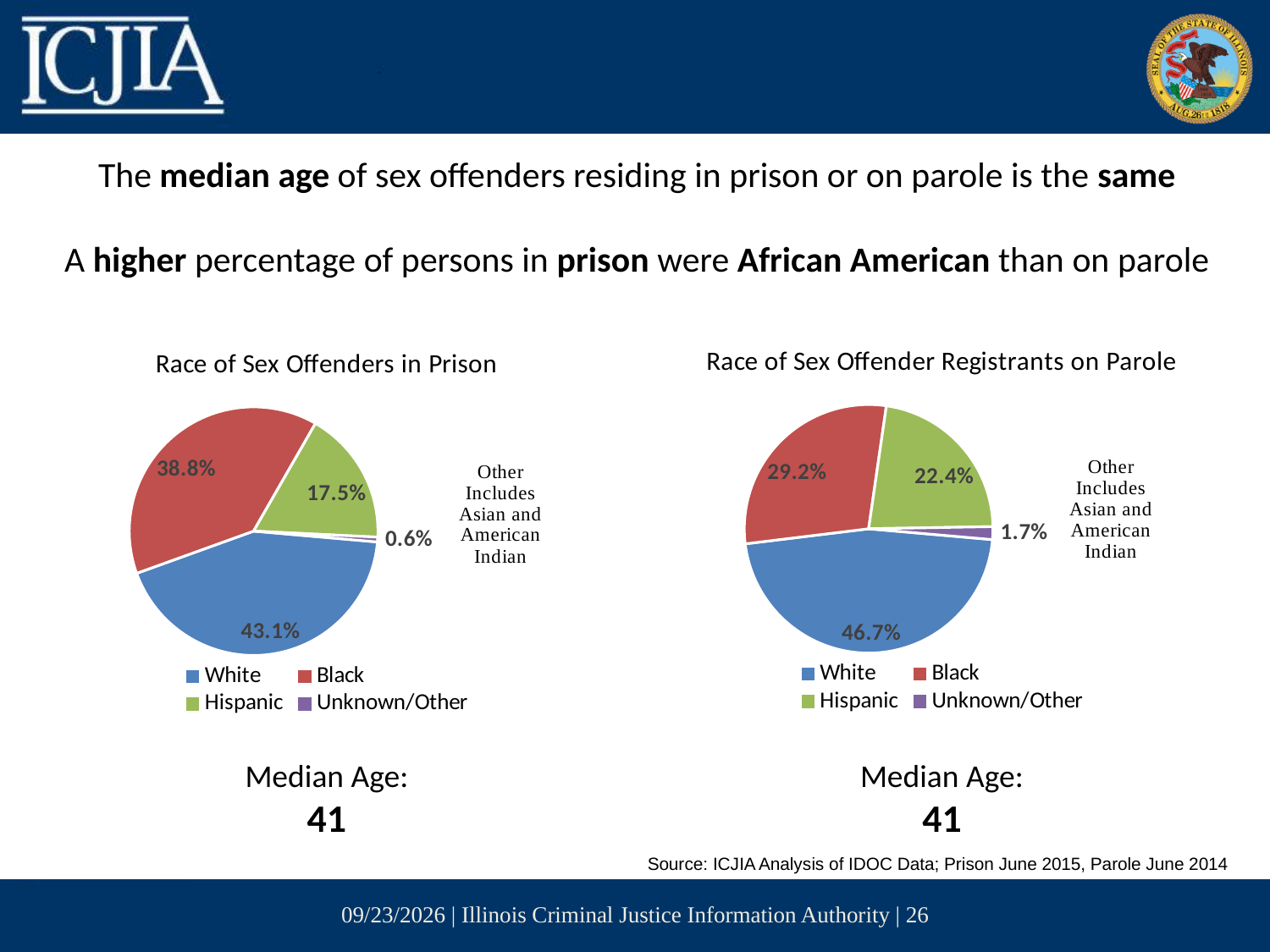
In the 'Race of Sex Offender Registrants on Parole' chart, which category has the smallest share? Unknown/Other In the 'Race of Sex Offenders in Prison' chart, what percentage is shown for White? 43.1% In the 'Race of Sex Offender Registrants on Parole' chart, what is the difference between the White and Black percentages? 17.5% In the 'Race of Sex Offenders in Prison' chart, what is the difference between the Hispanic and Unknown/Other percentages? 16.9% In the 'Race of Sex Offender Registrants on Parole' chart, what percentage is shown for Hispanic? 22.4% In the 'Race of Sex Offender Registrants on Parole' chart, what percentage is shown for Unknown/Other? 1.7% In the 'Race of Sex Offenders in Prison' chart, which colour represents Hispanic? Green In the 'Race of Sex Offenders in Prison' chart, how many categories does the legend list? 4 Which chart shows a larger percentage for Black: 'Race of Sex Offenders in Prison' or 'Race of Sex Offender Registrants on Parole'? Race of Sex Offenders in Prison What type of chart is 'Race of Sex Offender Registrants on Parole'? Pie chart In the 'Race of Sex Offenders in Prison' chart, what percentage is shown for Black? 38.8% In the 'Race of Sex Offenders in Prison' chart, which category has the largest share? White